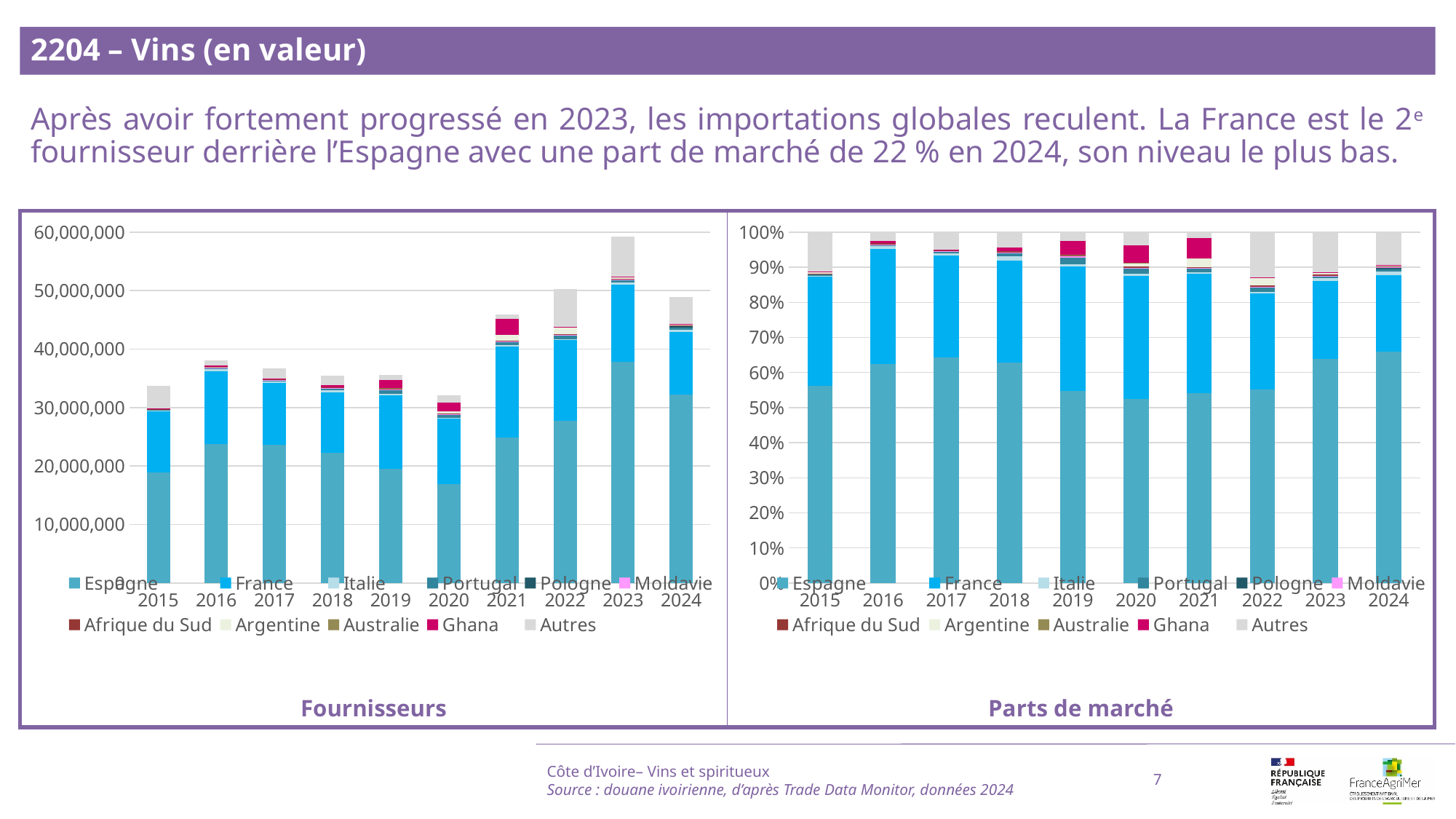
How many years are shown on the x axis of the 'Parts de marché' chart? 10 In the 'Fournisseurs' chart, is the Espagne segment for 2024 greater or less than 30,000,000? greater In the 'Fournisseurs' chart, is the total bar for 2020 greater or less than 40,000,000? less In the 'Fournisseurs' chart, which year has the tallest total bar? 2023 In the 'Fournisseurs' chart, which year has the lowest total bar? 2020 In the 'Fournisseurs' chart, do the total bars rise or fall from 2020 to 2023? rise What kind of chart is the 'Fournisseurs' chart? Stacked bar chart Which series is listed first in the legend of the 'Parts de marché' chart? Espagne In the 'Fournisseurs' chart, which total bar is taller, 2023 or 2024? 2023 How many series does the legend of the 'Fournisseurs' chart list? 11 In the 'Parts de marché' chart, is the Espagne share for 2024 greater or less than 60%? greater